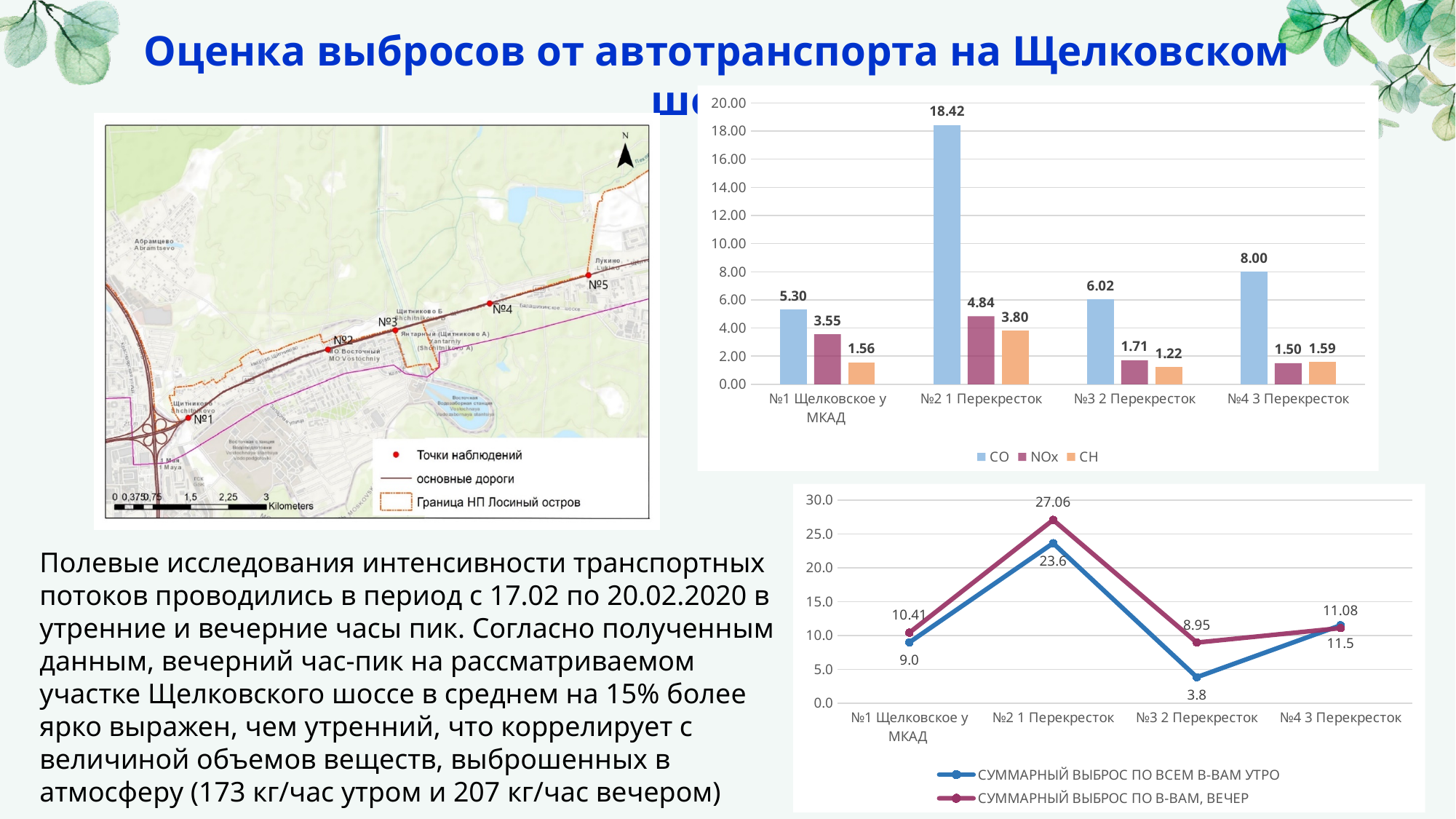
In the top bar chart, which category has the highest CO value? №2 1 Перекресток In the top bar chart, what is the NOx value for №1 Щелковское у МКАД? 3.55 In the bottom line chart, what is the morning value (СУММАРНЫЙ ВЫБРОС ПО ВСЕМ В-ВАМ УТРО) for №3 2 Перекресток? 3.8 In the top bar chart, which category has the lowest NOx value? №4 3 Перекресток How many series does the legend of the top bar chart list? 3 In the top bar chart, what is the CO value for №2 1 Перекресток? 18.42 In the bottom line chart, which is larger for №1 Щелковское у МКАД: the morning value or the evening value? Evening (10.41) What type of chart is the bottom chart on the slide? Line chart In the top bar chart, what is the difference between the CO values for №4 3 Перекресток and №3 2 Перекресток? 1.98 In the bottom line chart, what is the evening total emission value (СУММАРНЫЙ ВЫБРОС ПО В-ВАМ, ВЕЧЕР) for №2 1 Перекресток? 27.06 In the top bar chart, what is the CH value for №3 2 Перекресток? 1.22 How many categories are shown on the x axis of the bottom line chart? 4